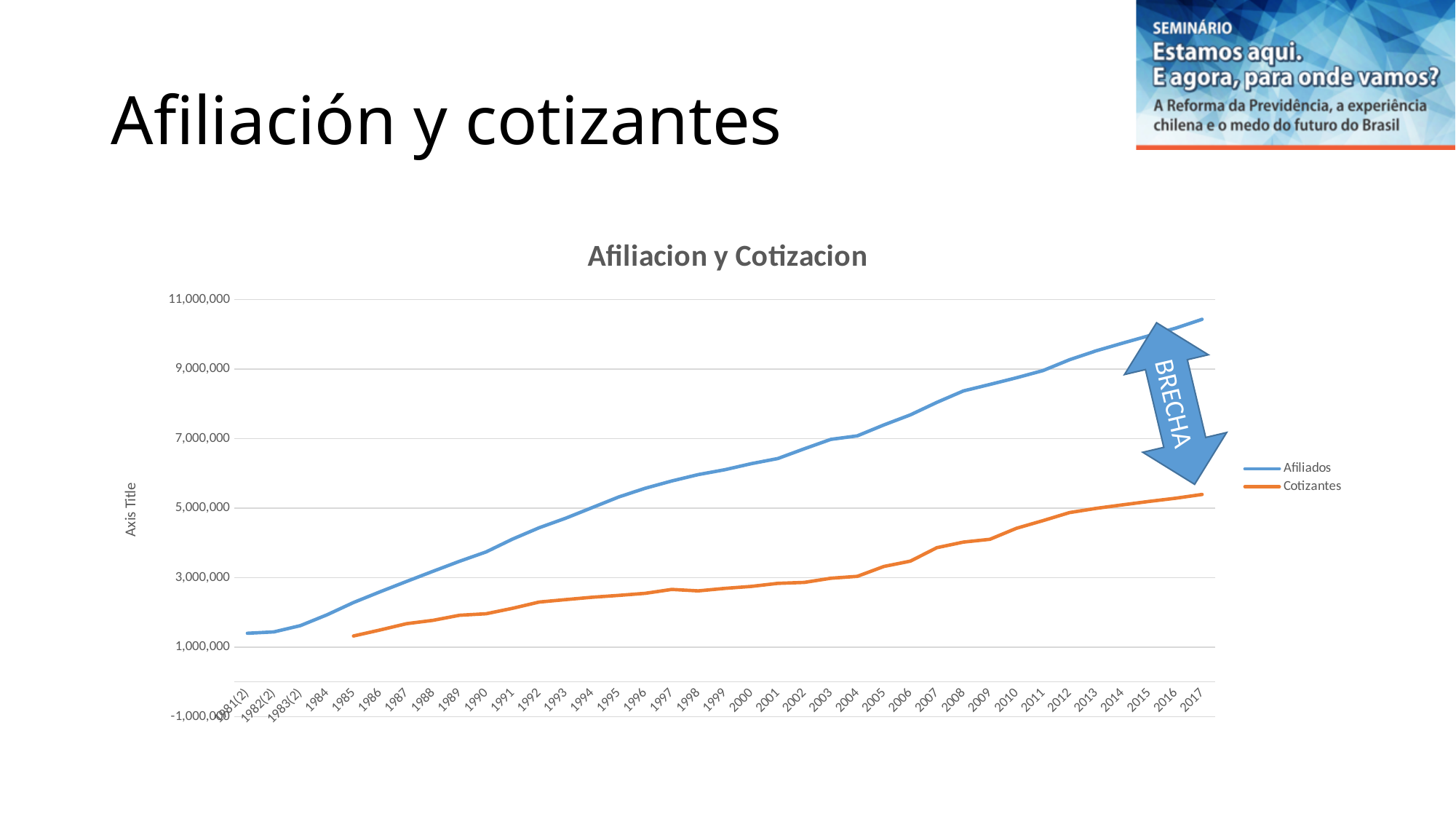
Is the value for Cotizantes in 2017 greater or less than 5,000,000? greater Do the Afiliados values rise or fall from 1981 to 2017? Rise Is the value for Afiliados in 2017 greater or less than 9,000,000? greater Is the value for Afiliados in 1985 greater or less than 3,000,000? less In 2017, which series has the larger value, Afiliados or Cotizantes? Afiliados In which year does the Afiliados series reach its highest value? 2017 What kind of chart is shown on the slide? Line chart How many series does the legend of the chart list? 2 What are the two series named in the chart legend? Afiliados and Cotizantes Do the Cotizantes values rise or fall from 1985 to 2017? Rise What is the title of the chart? Afiliacion y Cotizacion